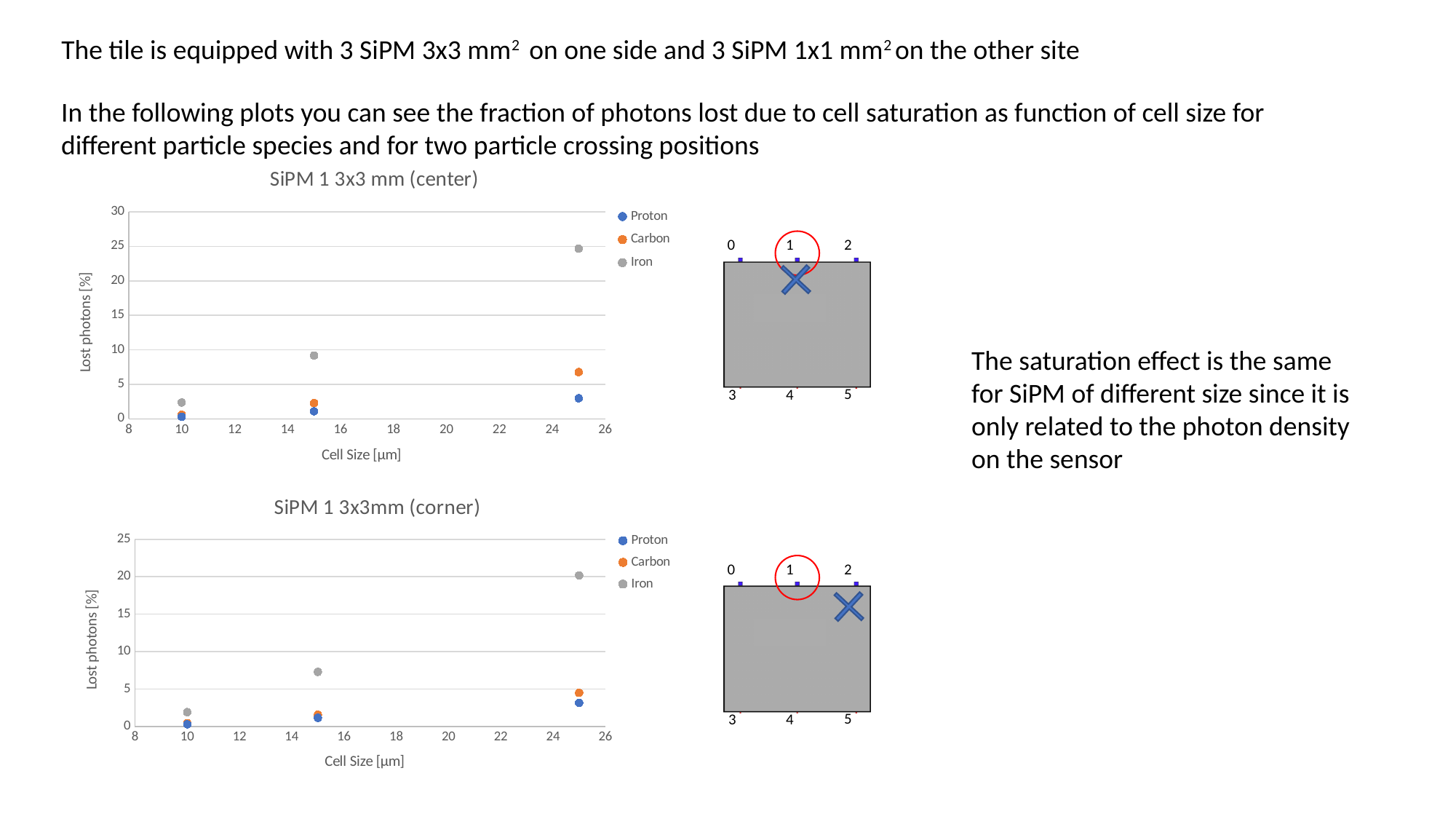
In the 'SiPM 1 3x3 mm (center)' chart, is the Carbon value at a cell size of 25 µm greater or less than 5? greater In the 'SiPM 1 3x3 mm (center)' chart, is the Iron value at a cell size of 15 µm greater or less than 10? less In the 'SiPM 1 3x3mm (corner)' chart, which is larger at a cell size of 25 µm: the Carbon value or the Proton value? Carbon How many data points are plotted for the Proton series in the 'SiPM 1 3x3mm (corner)' chart? 3 In the 'SiPM 1 3x3mm (corner)' chart, is the Iron value at a cell size of 15 µm greater or less than 5? greater In the 'SiPM 1 3x3 mm (center)' chart, which series has the highest lost photons value at a cell size of 25 µm? Iron How many series does the legend of the 'SiPM 1 3x3 mm (center)' chart list? 3 In the 'SiPM 1 3x3 mm (center)' chart, do the Iron values rise or fall as cell size increases? rise In the 'SiPM 1 3x3mm (corner)' chart, which series has the lowest lost photons value at a cell size of 25 µm? Proton What kind of chart is the 'SiPM 1 3x3 mm (center)' chart? scatter chart What is the y-axis label of the 'SiPM 1 3x3mm (corner)' chart? Lost photons [%]